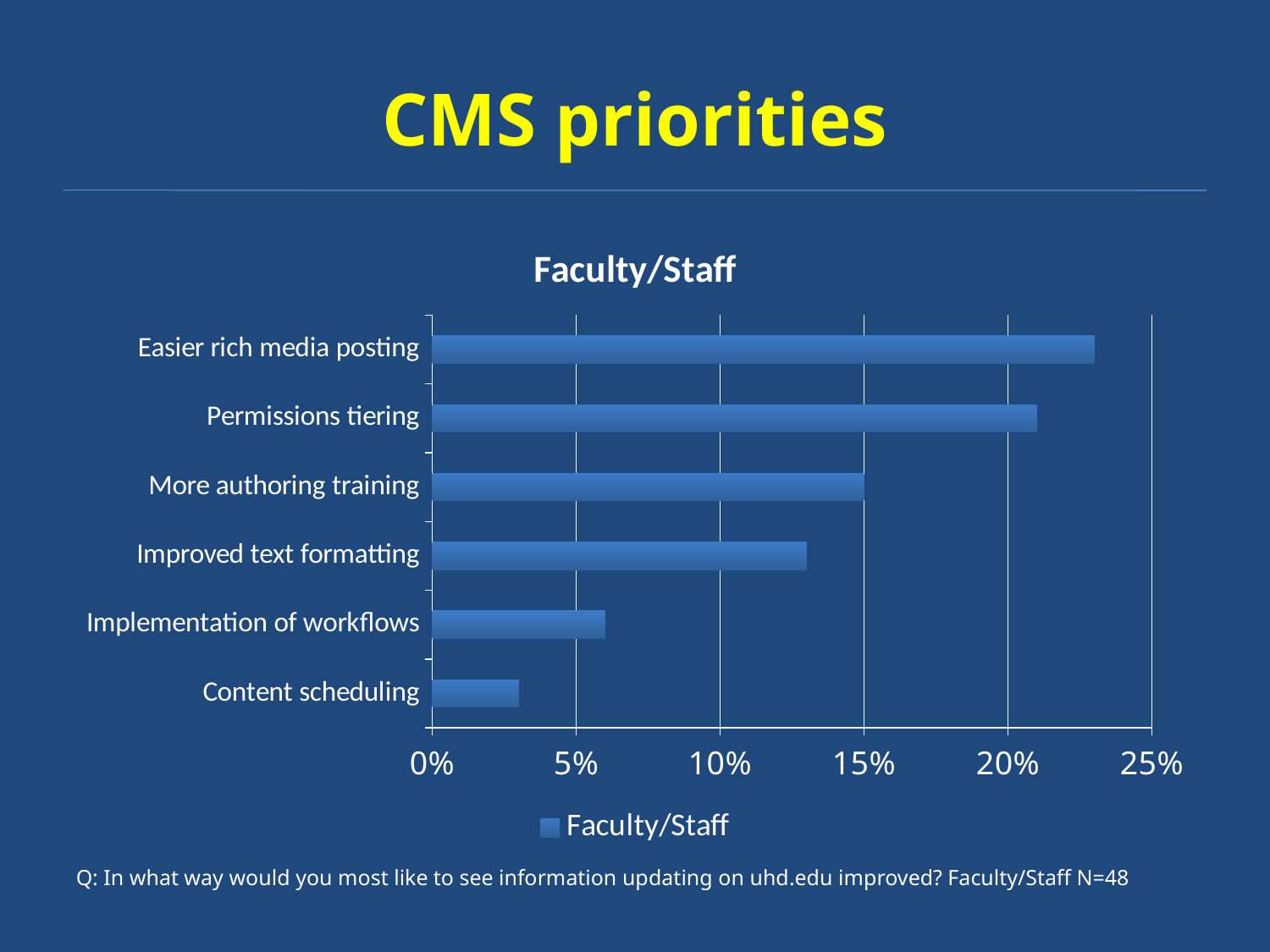
How many categories are plotted in the chart? 6 Which category has the lowest value? Content scheduling Is the value for Easier rich media posting greater or less than 20%? greater How many series does the legend list? 1 What is the title of the chart? Faculty/Staff Is the value for Implementation of workflows greater or less than 5%? greater Which category has the highest value? Easier rich media posting What kind of chart is shown on the slide? bar chart Is the value for Content scheduling greater or less than 5%? less What is the maximum value shown on the horizontal axis? 25% Which is larger, the value for Permissions tiering or the value for More authoring training? Permissions tiering